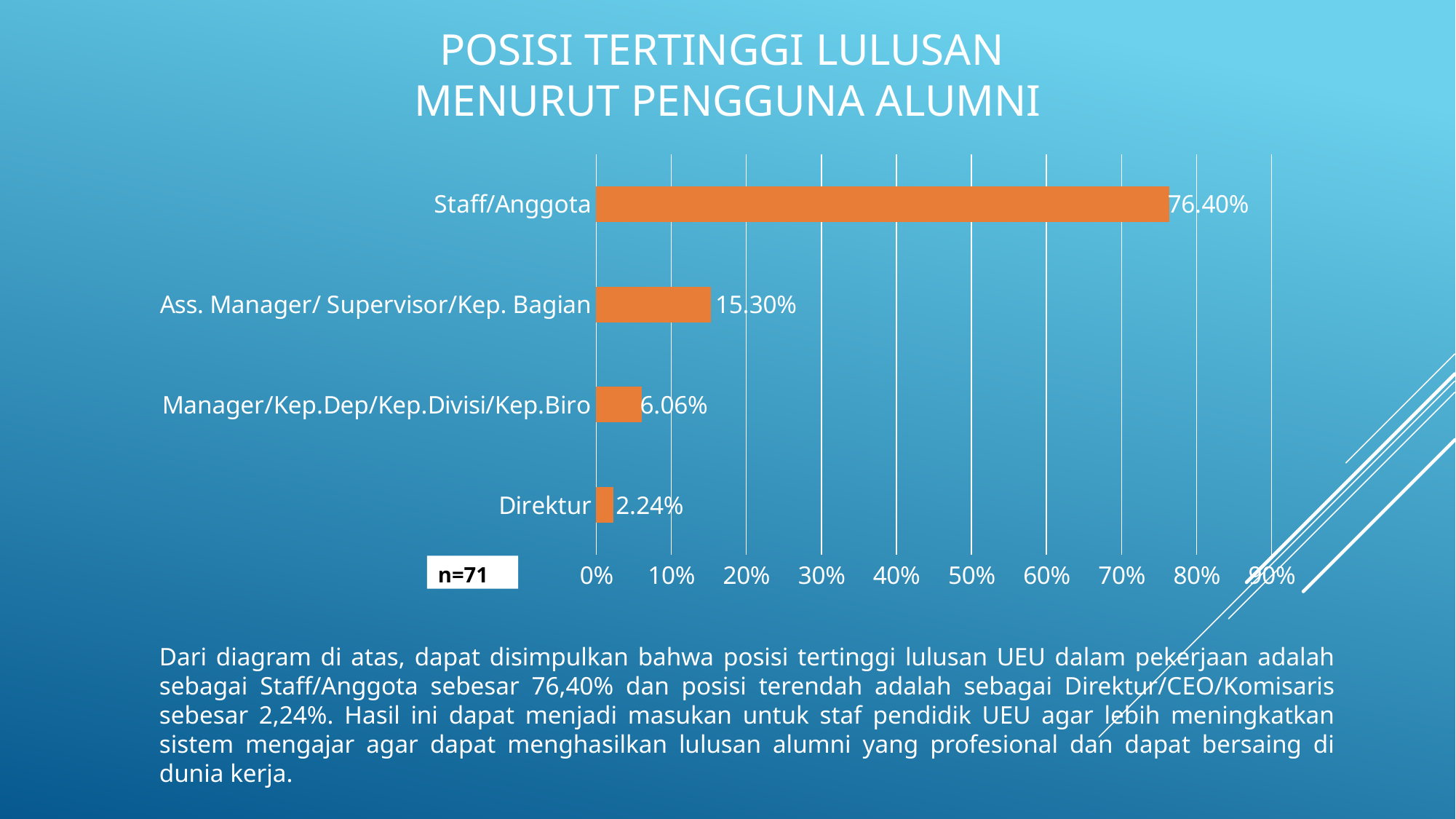
What is the difference between the values for Staff/Anggota and Ass. Manager/ Supervisor/Kep. Bagian? 61.10% Is the value for Staff/Anggota greater or less than 70%? greater Which is larger, the value for Manager/Kep.Dep/Kep.Divisi/Kep.Biro or the value for Direktur? Manager/Kep.Dep/Kep.Divisi/Kep.Biro What is the value for Staff/Anggota? 76.40% What sample size (n) is shown next to the chart? n=71 How many categories are shown in the chart? 4 What is the value for Direktur? 2.24% What is the value for Ass. Manager/ Supervisor/Kep. Bagian? 15.30% Which category has the highest value? Staff/Anggota Which category has the lowest value? Direktur What is the value for Manager/Kep.Dep/Kep.Divisi/Kep.Biro? 6.06% What kind of chart is shown on the slide? bar chart